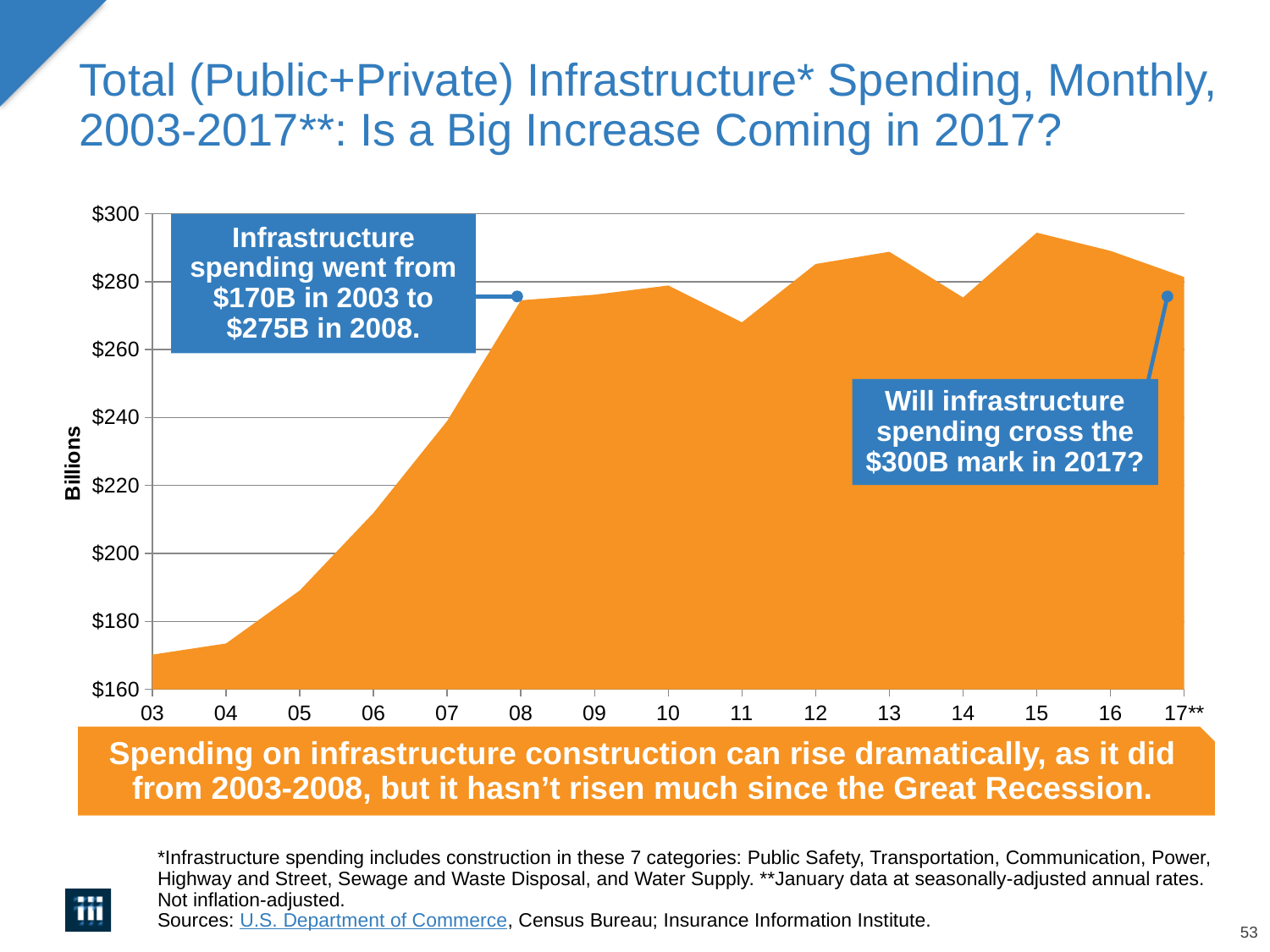
Which year has the lowest infrastructure spending on the chart? 03 Does infrastructure spending rise or fall from 2003 to 2008? Rise According to the callout, what was infrastructure spending in 2003? $170B By how much did infrastructure spending increase from 2003 to 2008, based on the callout values? $105B How many years are labeled on the x axis? 15 Is the value for 2005 greater or less than $200? less Is the value for 2015 greater or less than $280? greater Is the value for 2011 greater or less than $280? less Which year has the highest infrastructure spending on the chart? 15 What is the label on the y axis? Billions According to the callout, what was infrastructure spending in 2008? $275B What kind of chart is shown on the slide? Area chart